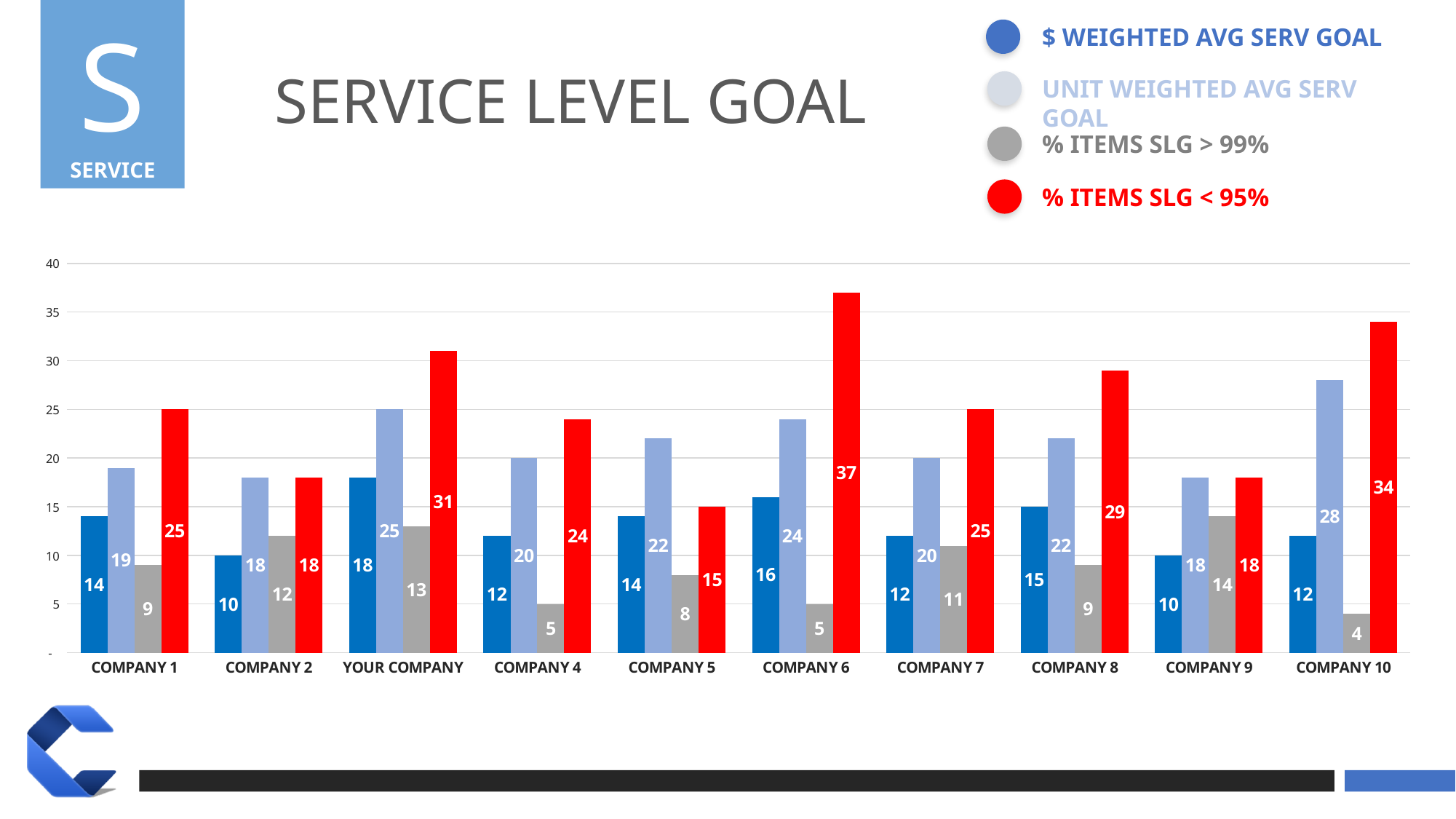
What is the % ITEMS SLG < 95% value for COMPANY 6? 37 How many companies are shown on the x axis? 10 Which company has the highest $ WEIGHTED AVG SERV GOAL value? YOUR COMPANY Which is larger: the UNIT WEIGHTED AVG SERV GOAL value for COMPANY 5 or for COMPANY 7? COMPANY 5 What is the % ITEMS SLG > 99% value for COMPANY 9? 14 Which company has the highest % ITEMS SLG < 95% value? COMPANY 6 How many series does the legend list? 4 What is the difference between the % ITEMS SLG < 95% values for COMPANY 6 and YOUR COMPANY? 6 Which company has the lowest % ITEMS SLG > 99% value? COMPANY 10 What is the $ WEIGHTED AVG SERV GOAL value for YOUR COMPANY? 18 What is the UNIT WEIGHTED AVG SERV GOAL value for COMPANY 10? 28 What type of chart is shown on the slide? Bar chart